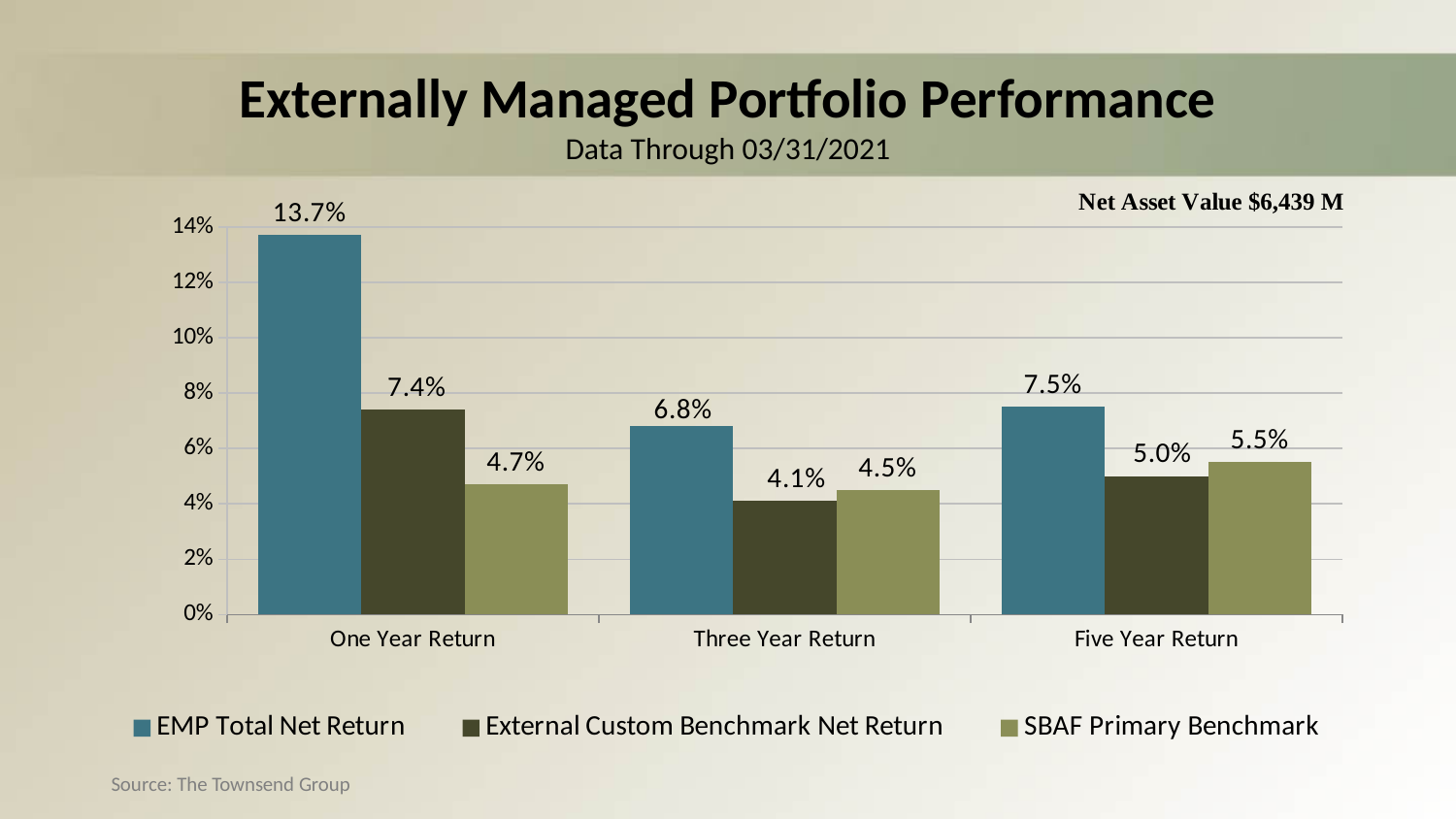
Which period has the highest EMP Total Net Return? One Year Return Is the EMP Total Net Return for Three Year Return greater or less than 6%? greater Which period has the lowest SBAF Primary Benchmark value? Three Year Return What is the EMP Total Net Return for One Year Return? 13.7% How many return periods are shown on the x axis? 3 How many series does the legend list? 3 What is the External Custom Benchmark Net Return for Three Year Return? 4.1% What is the SBAF Primary Benchmark value for Five Year Return? 5.5% What is the title of the chart? Externally Managed Portfolio Performance For Five Year Return, which is larger: the External Custom Benchmark Net Return or the SBAF Primary Benchmark? SBAF Primary Benchmark What is the difference between the EMP Total Net Return and the External Custom Benchmark Net Return for One Year Return? 6.3% What kind of chart is shown on the slide? Bar chart